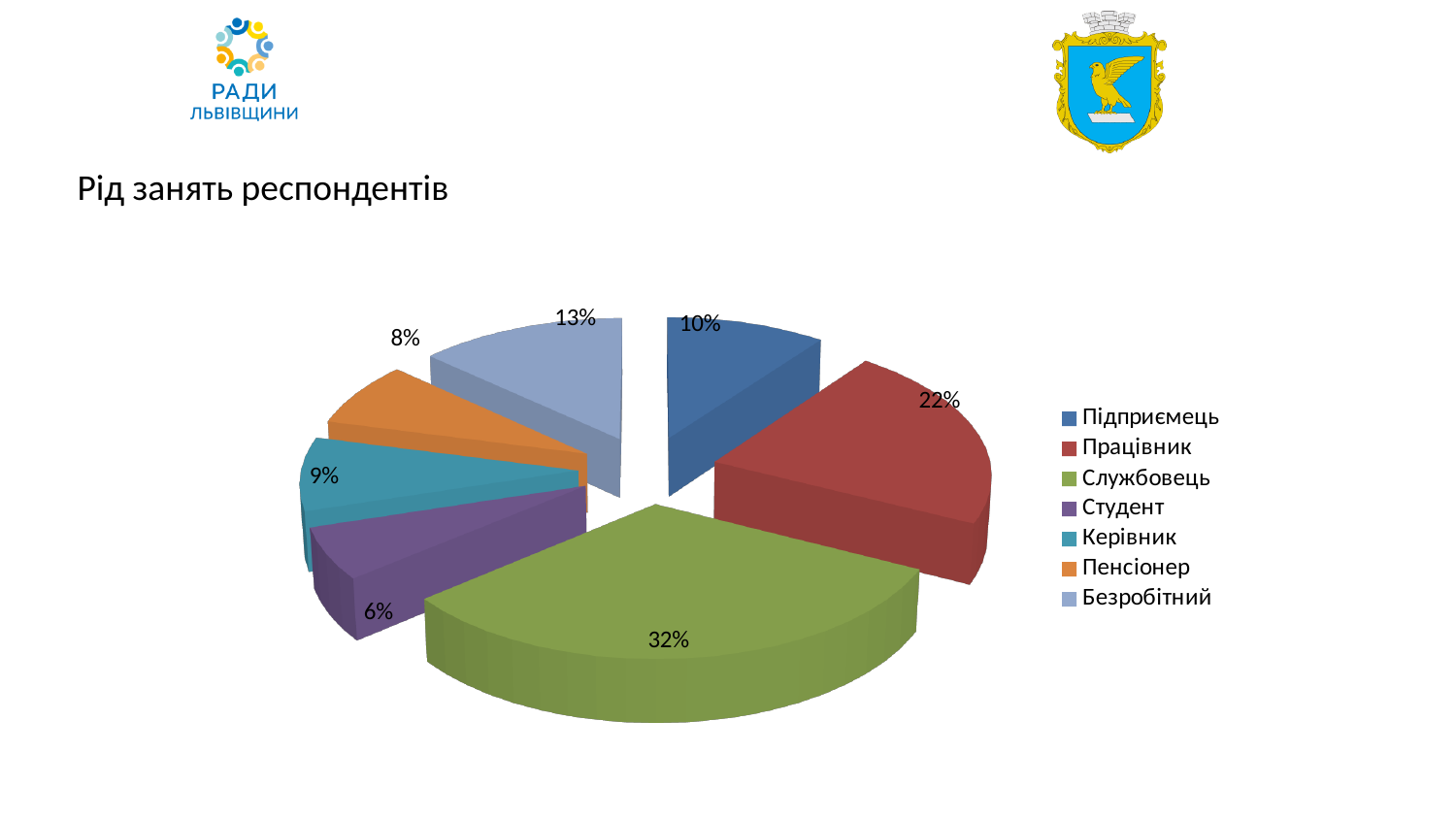
What share of respondents are Студент? 6% Which category has the smallest share of the pie? Студент Which category has the largest share of the pie? Службовець What share of respondents are Працівник? 22% What share of respondents are Службовець? 32% What is the difference in percentage points between Безробітний and Пенсіонер? 5 What share of respondents are Підприємець? 10% What type of chart is shown on the slide? pie chart What colour is the slice for Безробітний? light blue Which is larger, the share for Керівник or the share for Пенсіонер? Керівник What is the title of the chart? Рід занять респондентів How many categories does the pie chart have? 7